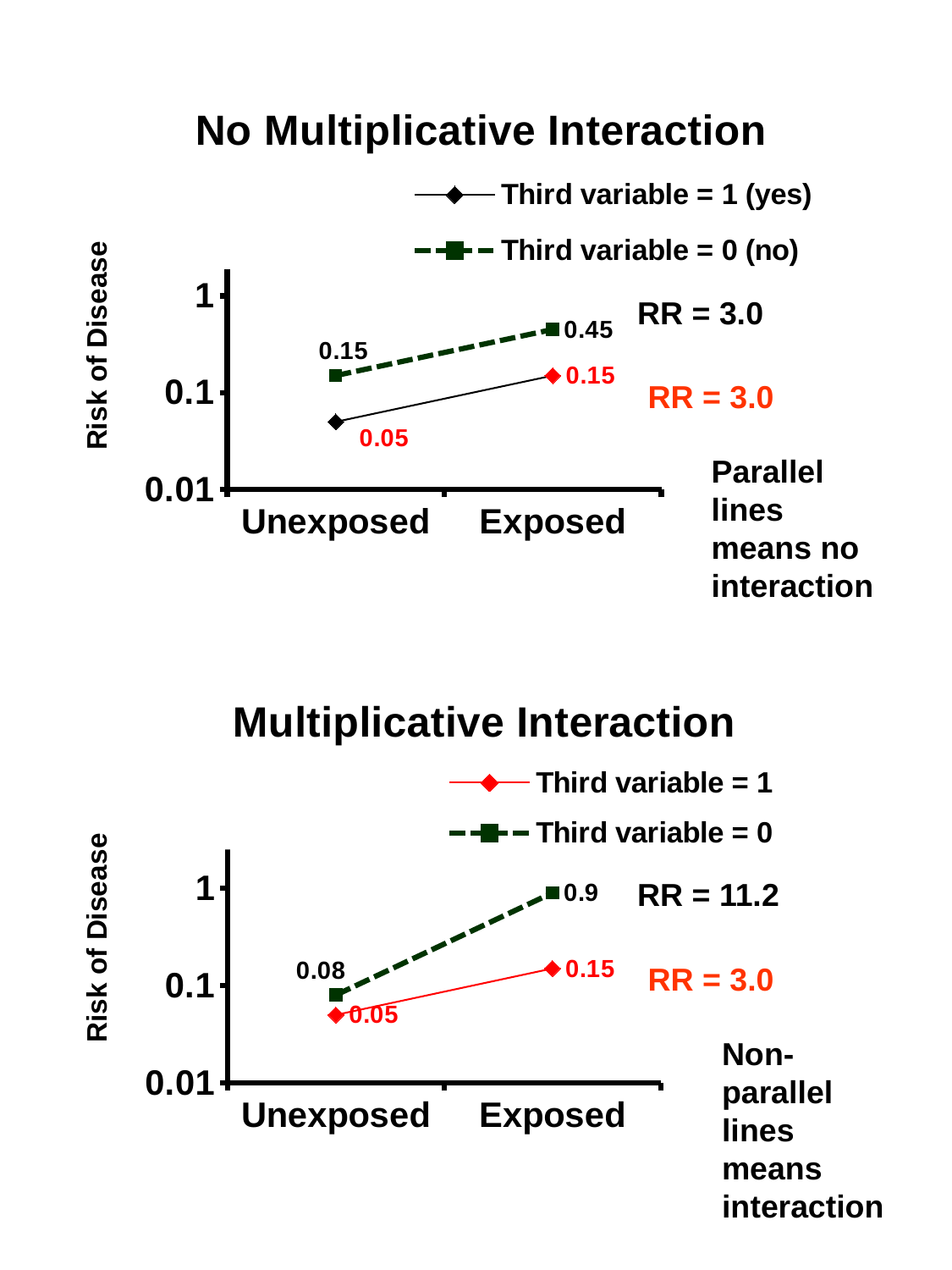
In the 'No Multiplicative Interaction' chart, what is the risk of disease for the Unexposed group when Third variable = 1 (yes)? 0.05 In the 'Multiplicative Interaction' chart, what is the difference in risk of disease between the Exposed and Unexposed groups for Third variable = 1? 0.1 In the 'Multiplicative Interaction' chart, what is the risk of disease for the Unexposed group when Third variable = 0? 0.08 What kind of chart is the 'Multiplicative Interaction' chart? Line chart In the 'No Multiplicative Interaction' chart, what is the difference in risk of disease between the Exposed and Unexposed groups for Third variable = 0 (no)? 0.3 In the 'No Multiplicative Interaction' chart, which data point has the highest risk of disease? Exposed, Third variable = 0 (no) In the 'No Multiplicative Interaction' chart, what is the risk of disease for the Exposed group when Third variable = 0 (no)? 0.45 In the 'Multiplicative Interaction' chart, which data point has the lowest risk of disease? Unexposed, Third variable = 1 In the 'Multiplicative Interaction' chart, does the risk of disease for Third variable = 0 rise or fall from Unexposed to Exposed? Rise In the 'Multiplicative Interaction' chart, which series has the higher risk of disease for the Exposed group? Third variable = 0 In the 'Multiplicative Interaction' chart, what is the risk of disease for the Exposed group when Third variable = 0? 0.9 How many series does the legend of the 'No Multiplicative Interaction' chart list? 2